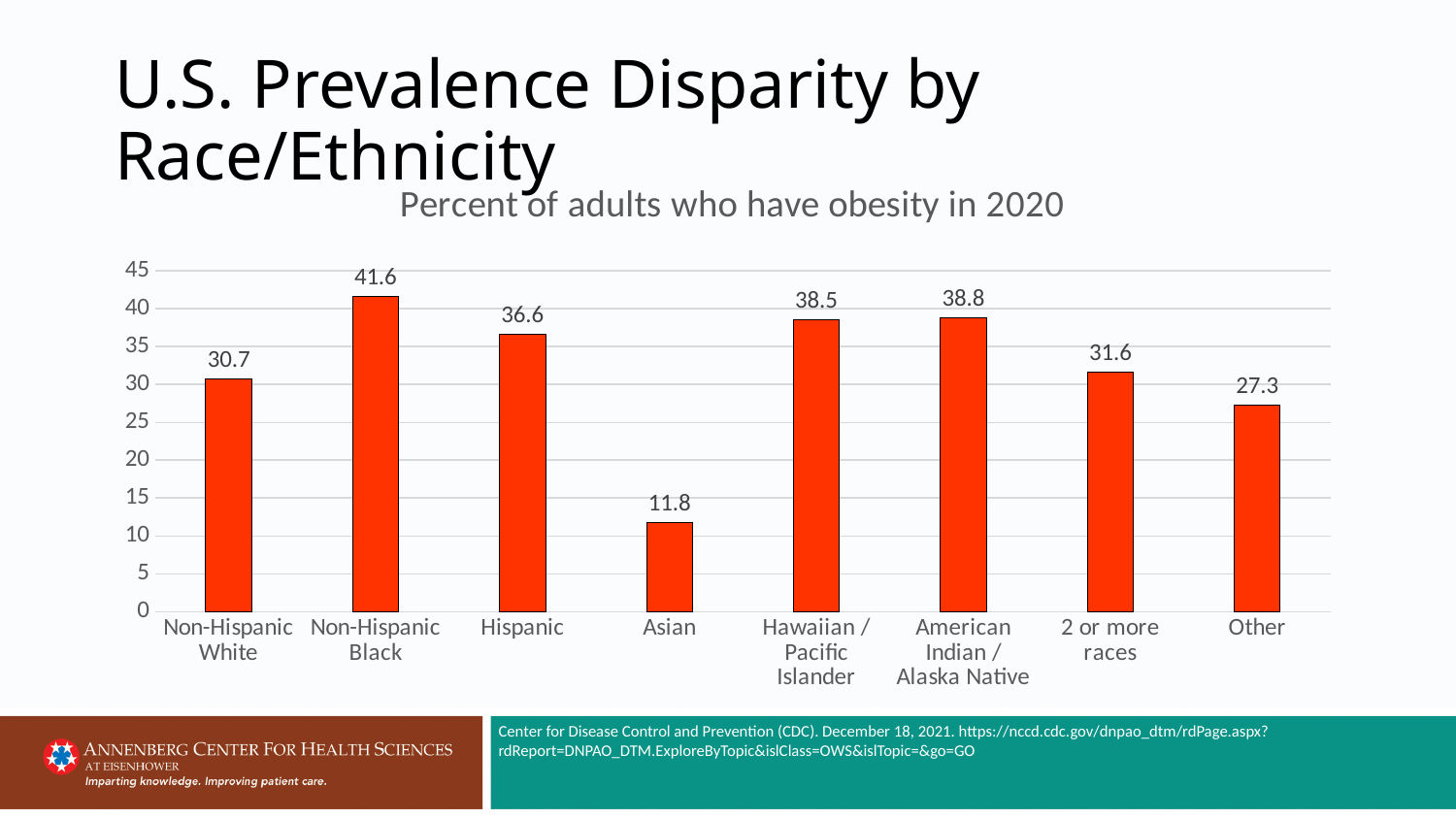
Which category has the highest value? Non-Hispanic Black What is the value for Hawaiian / Pacific Islander? 38.5 What kind of chart is this? bar chart Which is larger, the value for Hispanic or the value for 2 or more races? Hispanic What is the difference between the values for American Indian / Alaska Native and Hawaiian / Pacific Islander? 0.3 Is the value for Other greater or less than 30? less What is the title of the chart? Percent of adults who have obesity in 2020 What is the difference between the values for Non-Hispanic Black and Non-Hispanic White? 10.9 What is the value for Non-Hispanic Black? 41.6 What is the value for Asian? 11.8 How many categories are shown on the x axis? 8 Which category has the lowest value? Asian